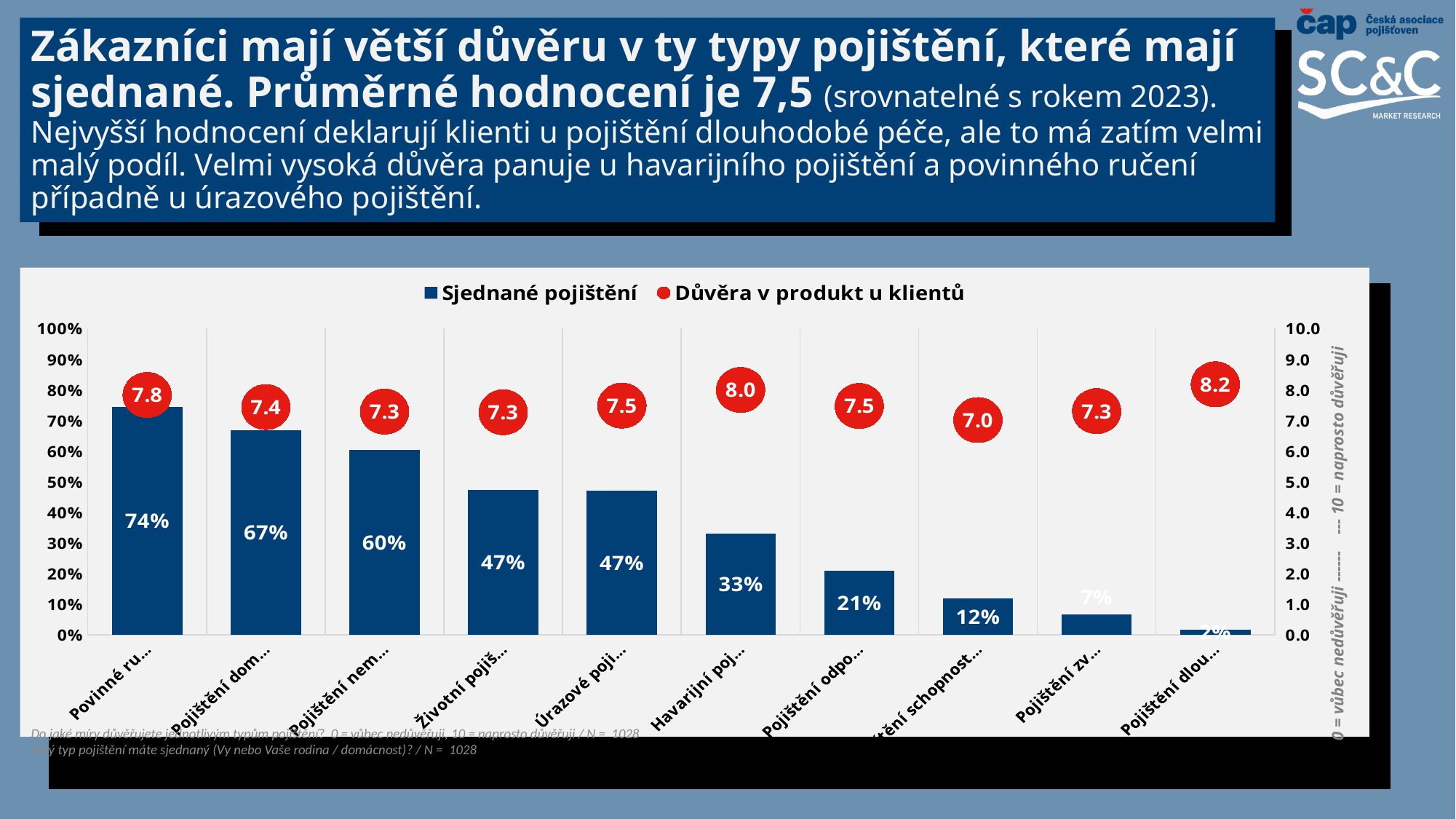
What is the 'Důvěra v produkt u klientů' score for the last (rightmost) category, 'Pojištění dlou...'? 8.2 Do the 'Sjednané pojištění' bars rise or fall from left to right along the x axis? fall Which has the higher 'Důvěra v produkt u klientů' score: 'Havarijní poj...' or 'Povinné ru...'? Havarijní poj... What is the 'Sjednané pojištění' value for the category labelled 'Havarijní poj...'? 33% What kind of chart is shown on the slide? bar chart What is the maximum value shown on the right-hand axis? 10.0 What is the lowest 'Důvěra v produkt u klientů' score shown in the chart? 7.0 What is the highest 'Důvěra v produkt u klientů' score shown in the chart? 8.2 How many categories are plotted along the x axis? 10 How many series does the legend list? 2 What is the 'Sjednané pojištění' value for the first (leftmost) category, 'Povinné ru...'? 74% What is the difference in 'Sjednané pojištění' between the first category (74%) and the second category (67%)? 7 percentage points